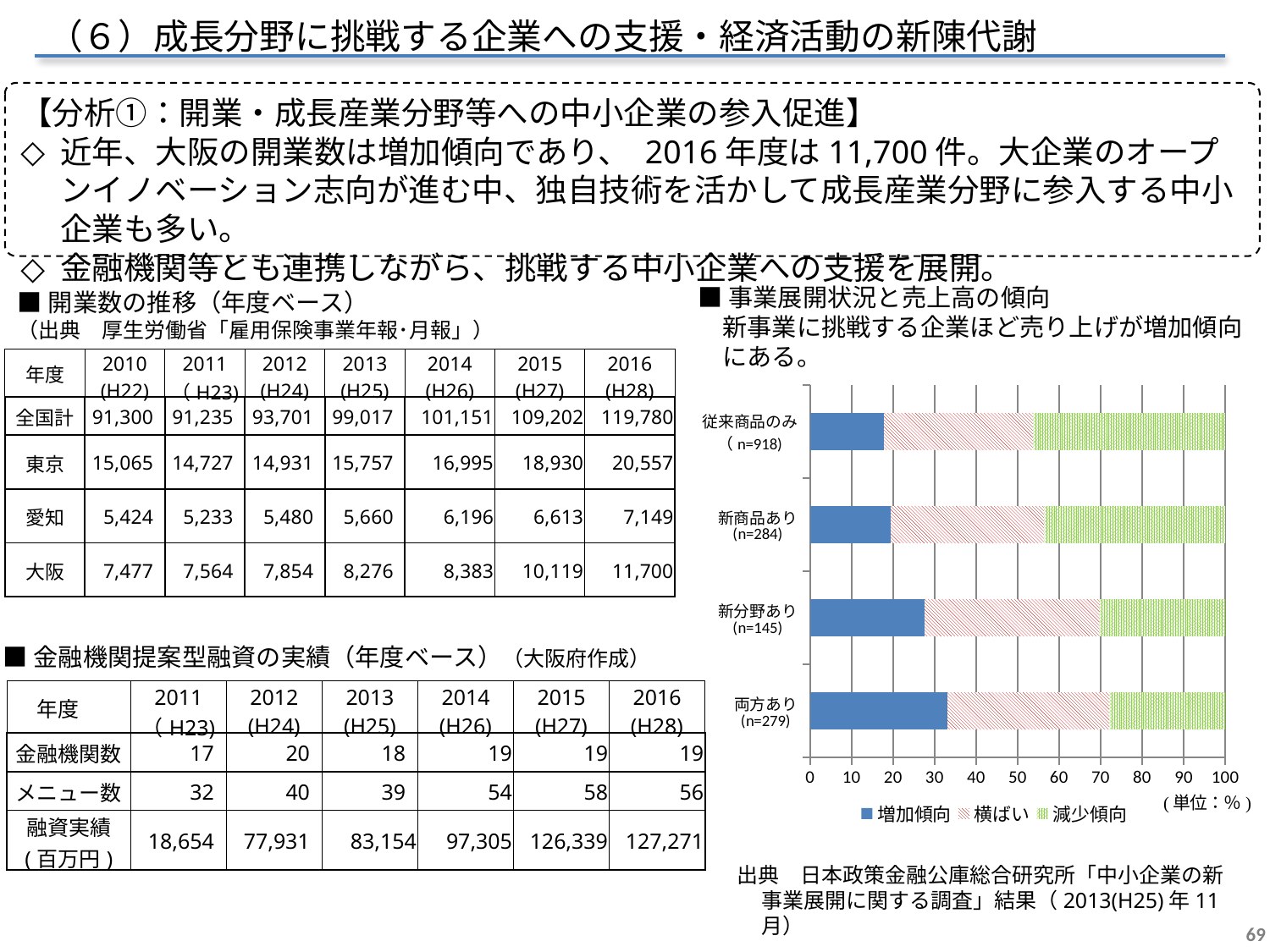
In the 事業展開状況と売上高の傾向 chart, is the 増加傾向 share for 両方あり greater or less than 30? greater In the 事業展開状況と売上高の傾向 chart, which has the larger 増加傾向 share: 新分野あり or 従来商品のみ? 新分野あり How many series does the legend of the 事業展開状況と売上高の傾向 chart list? 3 What are the three legend entries of the 事業展開状況と売上高の傾向 chart? 増加傾向, 横ばい, 減少傾向 In the 事業展開状況と売上高の傾向 chart, is the 減少傾向 share for 両方あり greater or less than 40? less What kind of chart is shown under the heading 事業展開状況と売上高の傾向? Stacked bar chart In the 事業展開状況と売上高の傾向 chart, which category has the smallest 増加傾向 share? 従来商品のみ In the 事業展開状況と売上高の傾向 chart, is the 増加傾向 share for 従来商品のみ greater or less than 20? less In the 事業展開状況と売上高の傾向 chart, which category has the largest 増加傾向 share? 両方あり How many categories (company groups) are plotted in the 事業展開状況と売上高の傾向 chart? 4 In the 事業展開状況と売上高の傾向 chart, does the 増加傾向 share rise or fall going from 従来商品のみ down to 両方あり? rise